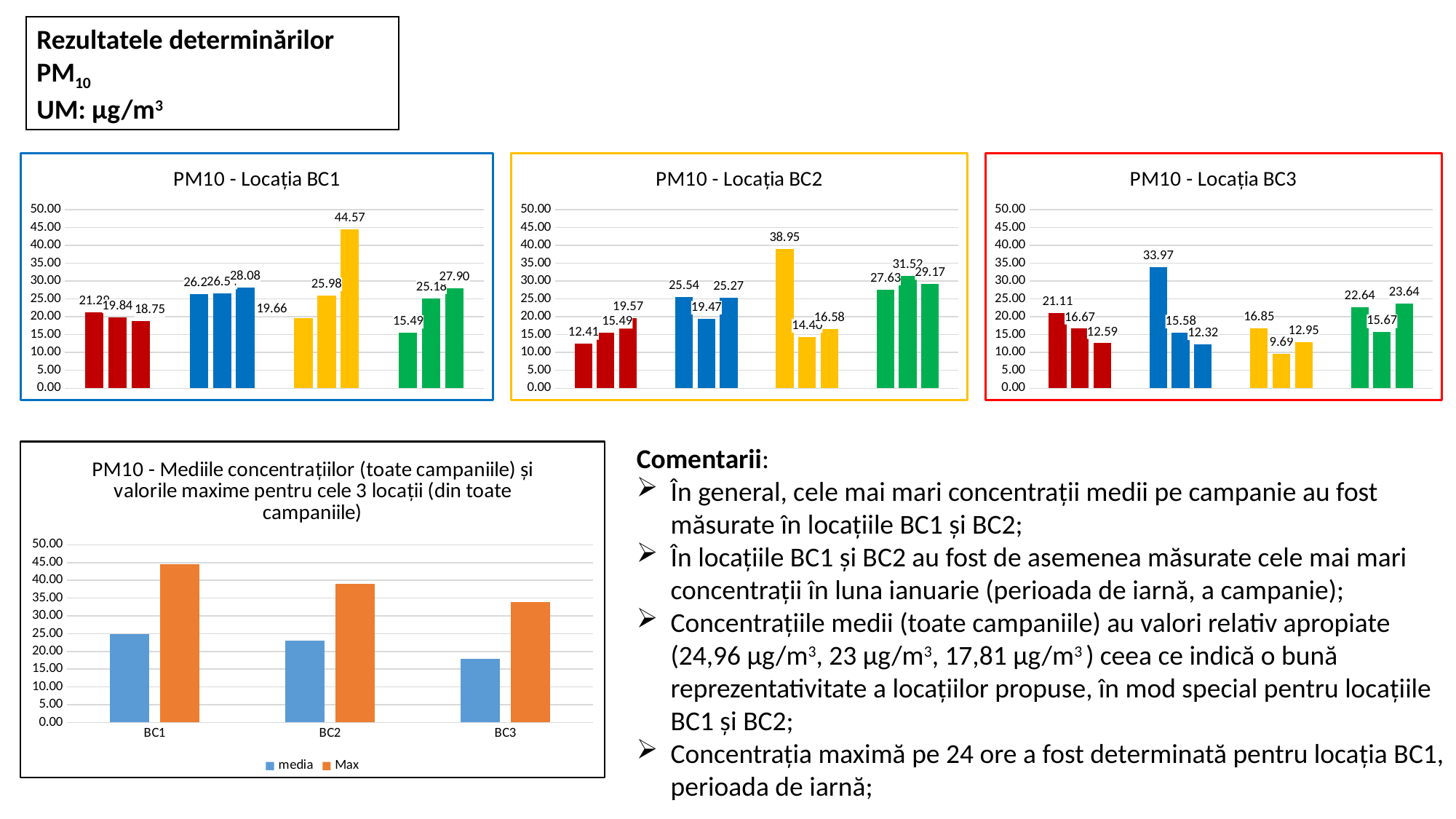
In the chart 'PM10 - Locația BC3', what is the highest value labelled on a bar? 33.97 In the bottom-left chart ('PM10 - Mediile concentrațiilor...'), do the 'Max' values rise or fall from BC1 to BC3? fall In the chart 'PM10 - Locația BC2', what is the highest value labelled on a bar? 38.95 In the bottom-left chart ('PM10 - Mediile concentrațiilor...'), is the 'Max' value for BC1 greater or less than 40.00? greater How many categories are shown on the x axis of the bottom-left chart ('PM10 - Mediile concentrațiilor...')? 3 What kind of chart is 'PM10 - Locația BC1'? bar chart In the chart 'PM10 - Locația BC1', what is the lowest value labelled on a bar? 15.49 In the chart 'PM10 - Locația BC3', what is the lowest value labelled on a bar? 9.69 In the chart 'PM10 - Locația BC1', what is the highest value labelled on a bar? 44.57 In the chart 'PM10 - Locația BC2', what is the lowest value labelled on a bar? 12.41 In the chart 'PM10 - Locația BC1', what is the difference between the highest labelled value (44.57) and the lowest labelled value (15.49)? 29.08 How many series does the legend of the bottom-left chart ('PM10 - Mediile concentrațiilor...') list? 2